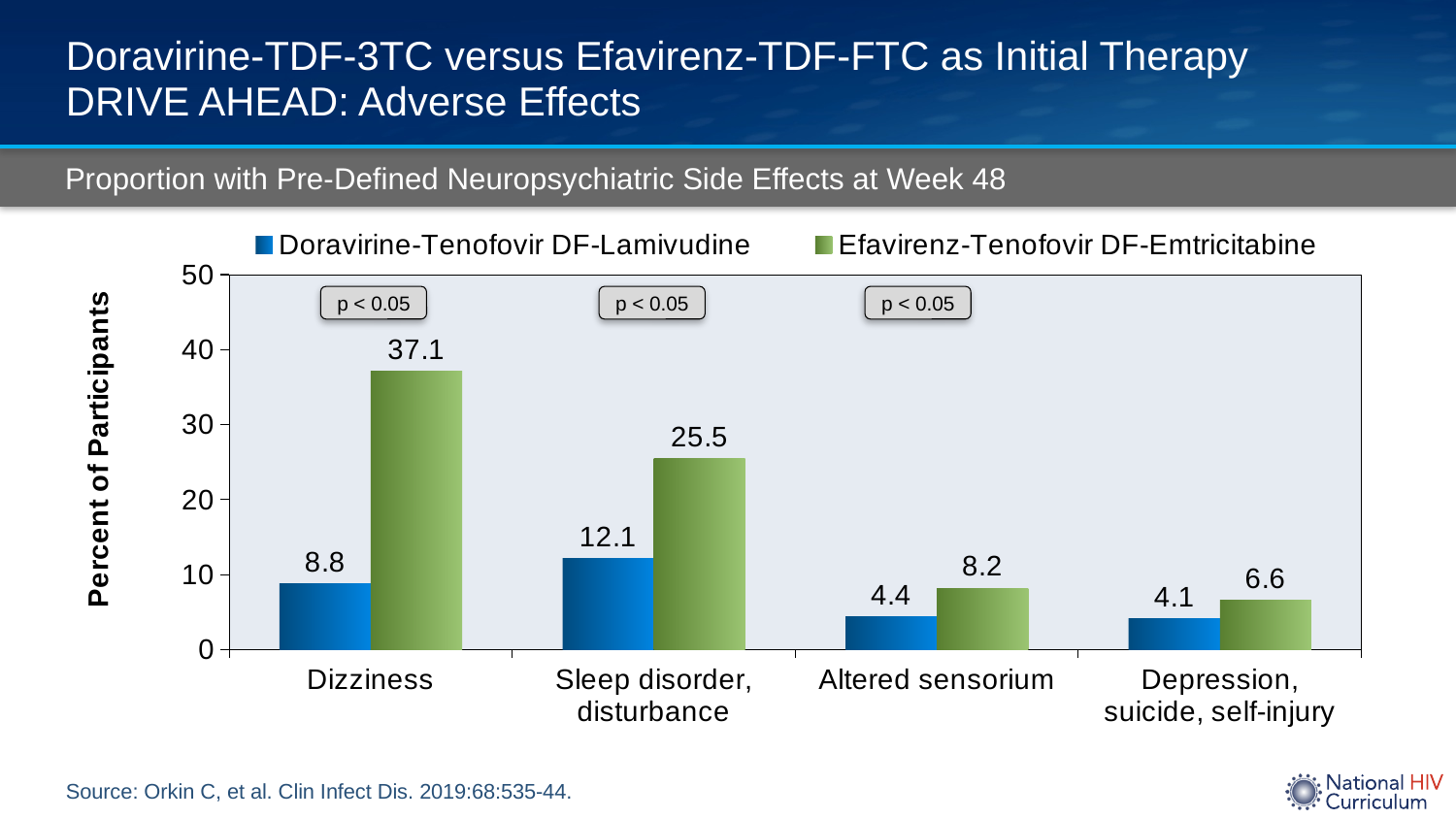
What is the difference between the Efavirenz-Tenofovir DF-Emtricitabine and Doravirine-Tenofovir DF-Lamivudine values for Dizziness? 28.3 How many categories are shown on the x axis? 4 What is the value for Doravirine-Tenofovir DF-Lamivudine for Dizziness? 8.8 What is the value for Efavirenz-Tenofovir DF-Emtricitabine for Depression, suicide, self-injury? 6.6 How many series does the legend list? 2 What is the value for Efavirenz-Tenofovir DF-Emtricitabine for Sleep disorder, disturbance? 25.5 What kind of chart is shown on the slide? Bar chart Which category has the highest value for Efavirenz-Tenofovir DF-Emtricitabine? Dizziness What is the value for Doravirine-Tenofovir DF-Lamivudine for Altered sensorium? 4.4 Which series has the larger value for Sleep disorder, disturbance? Efavirenz-Tenofovir DF-Emtricitabine Is the value for Efavirenz-Tenofovir DF-Emtricitabine for Dizziness greater or less than 30? greater Which category has the lowest value for Doravirine-Tenofovir DF-Lamivudine? Depression, suicide, self-injury